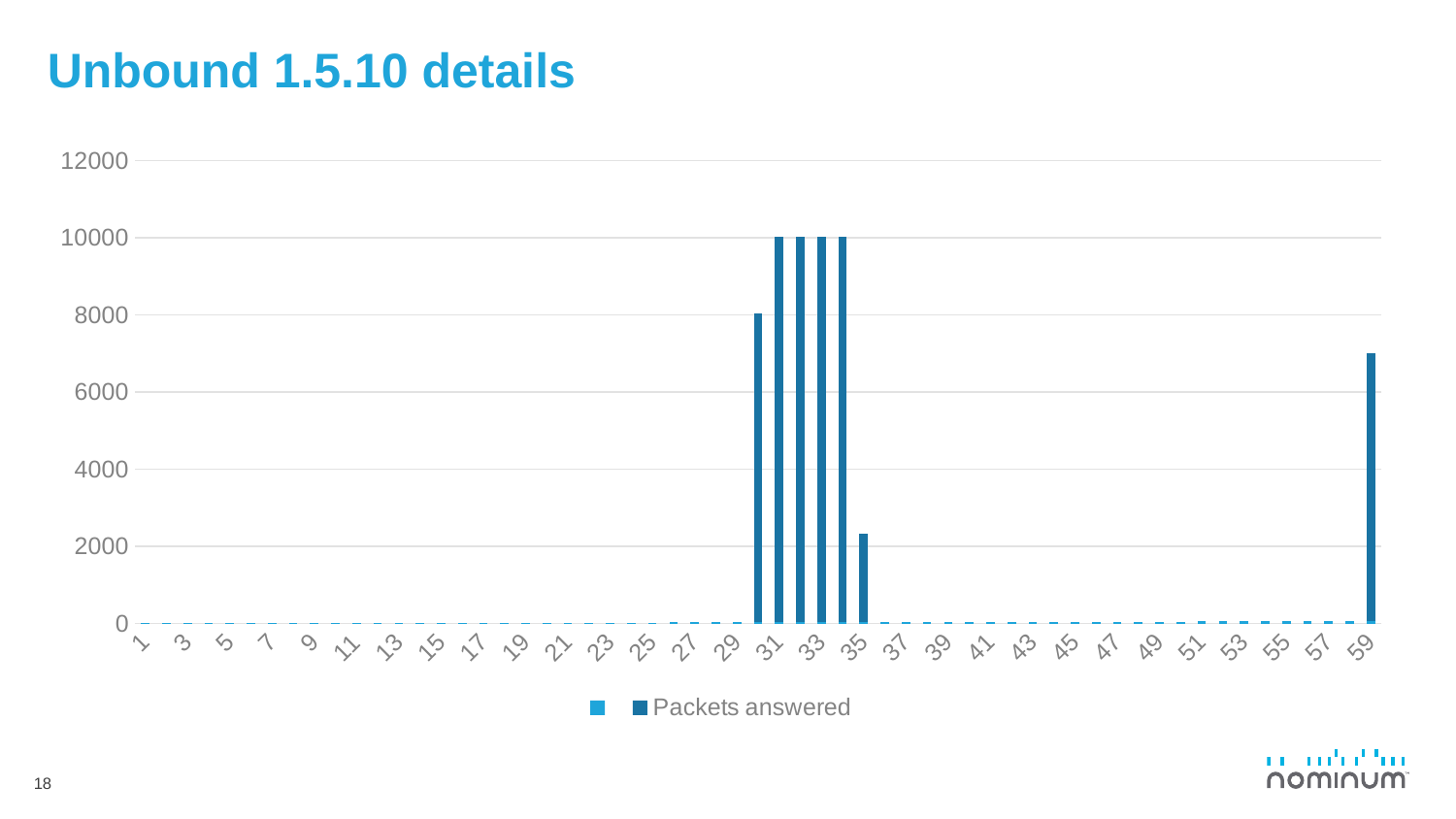
Is the value for category 35 greater or less than 4000? less Is the value for category 59 greater or less than 6000? greater What is the value of the bar at category 30? 8000 What is the title of the slide containing the chart? Unbound 1.5.10 details What is the highest value reached by any bar in the chart? 10000 What type of chart is shown on the slide? bar chart Is the value for category 59 greater or less than 8000? less What is the maximum value shown on the y axis? 12000 What is the named series in the chart legend? Packets answered How many bars reach the 10000 level? 4 Which is larger, the value at category 31 or the value at category 59? category 31 What is the value of the bar at category 31? 10000